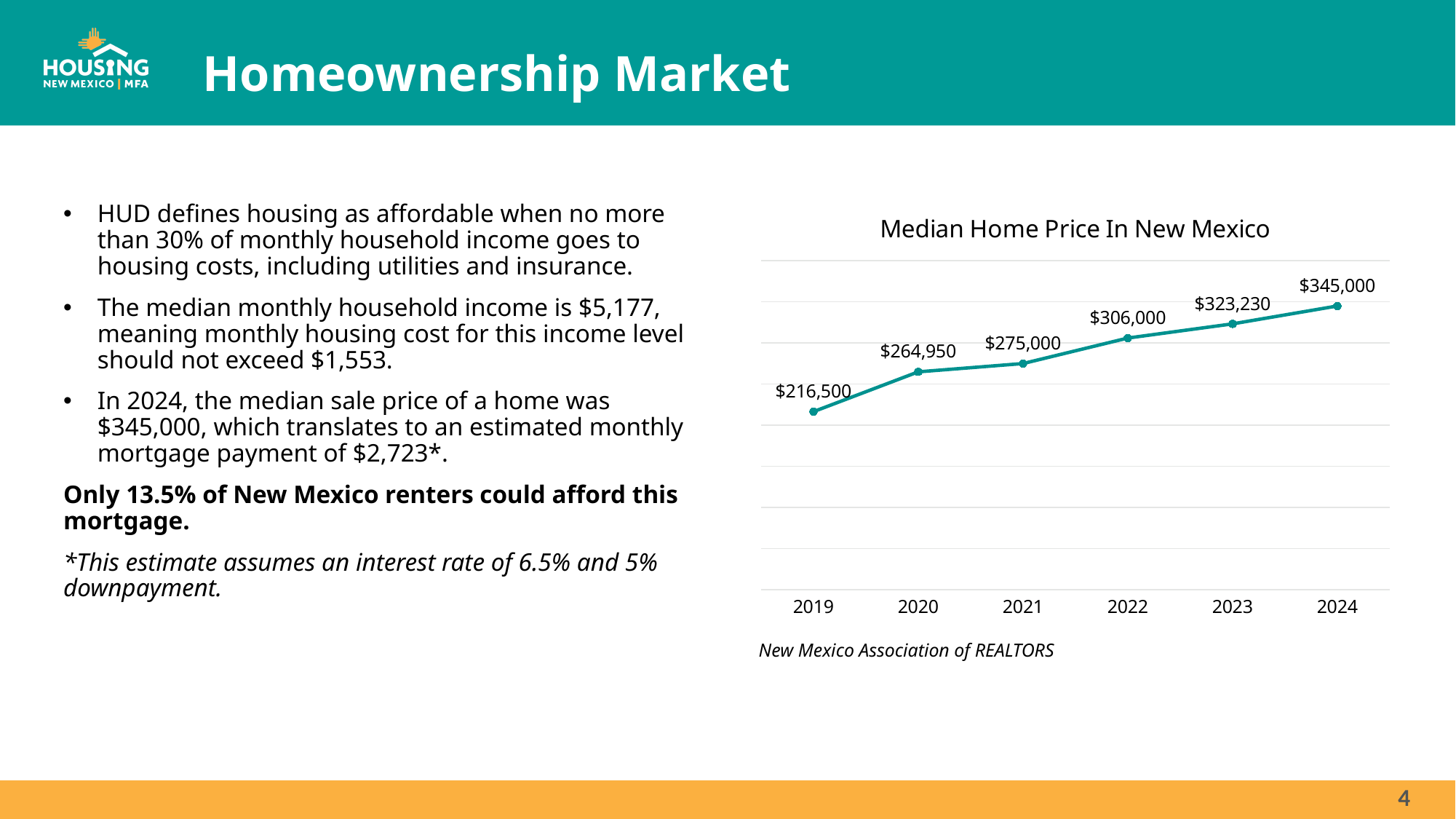
What was the median home price in New Mexico in 2022? $306,000 Which year had a higher median home price, 2020 or 2022? 2022 What is the difference between the median home price in 2024 and in 2019? $128,500 Which year has the lowest median home price on the chart? 2019 What is the difference between the median home price in 2021 and in 2020? $10,050 What was the median home price in New Mexico in 2023? $323,230 How many years are plotted on the Median Home Price In New Mexico chart? 6 What kind of chart is used to show the median home price in New Mexico? Line chart What is the title of the chart on the slide? Median Home Price In New Mexico What was the median home price in New Mexico in 2019? $216,500 Does the median home price rise or fall from 2019 to 2024? Rise Which year has the highest median home price on the chart? 2024